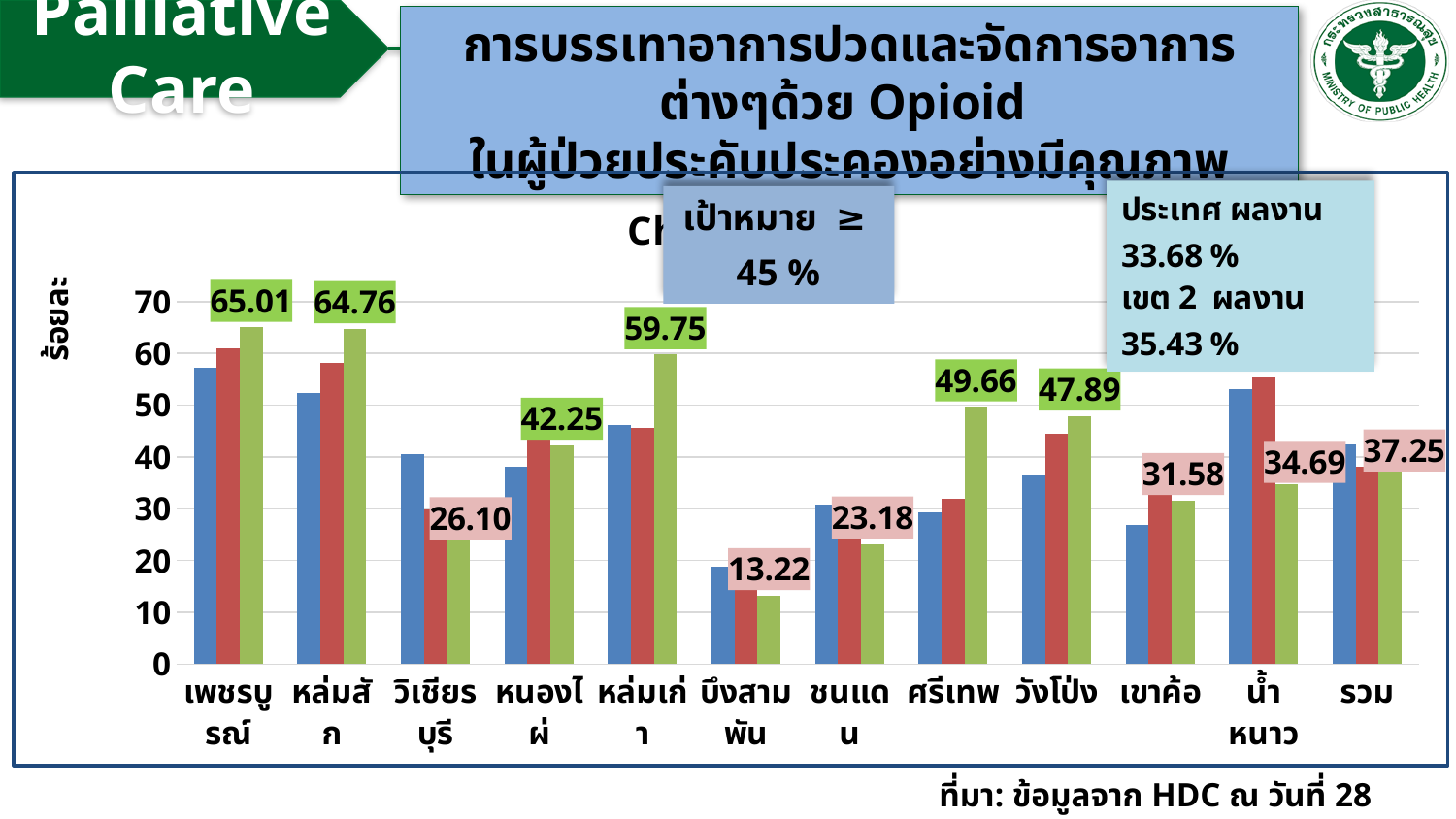
What is the labelled value for the green bar for เพชรบูรณ์? 65.01 How many categories are shown on the x axis of the chart? 12 What is the difference between the labelled green-bar values for เพชรบูรณ์ and หล่มสัก? 0.25 What is the difference between the labelled green-bar values for ศรีเทพ and วังโป่ง? 1.77 Which category has the lowest labelled green-bar value? บึงสามพัน What is the labelled value for the green bar for รวม? 37.25 What is the labelled value for the green bar for หล่มเก่า? 59.75 What kind of chart is shown on the slide? bar chart What is the labelled value for the green bar for บึงสามพัน? 13.22 Which category has the highest labelled green-bar value? เพชรบูรณ์ Which has the larger labelled green-bar value, หล่มเก่า or ศรีเทพ? หล่มเก่า Is the value of the blue bar for เพชรบูรณ์ greater or less than 50? greater